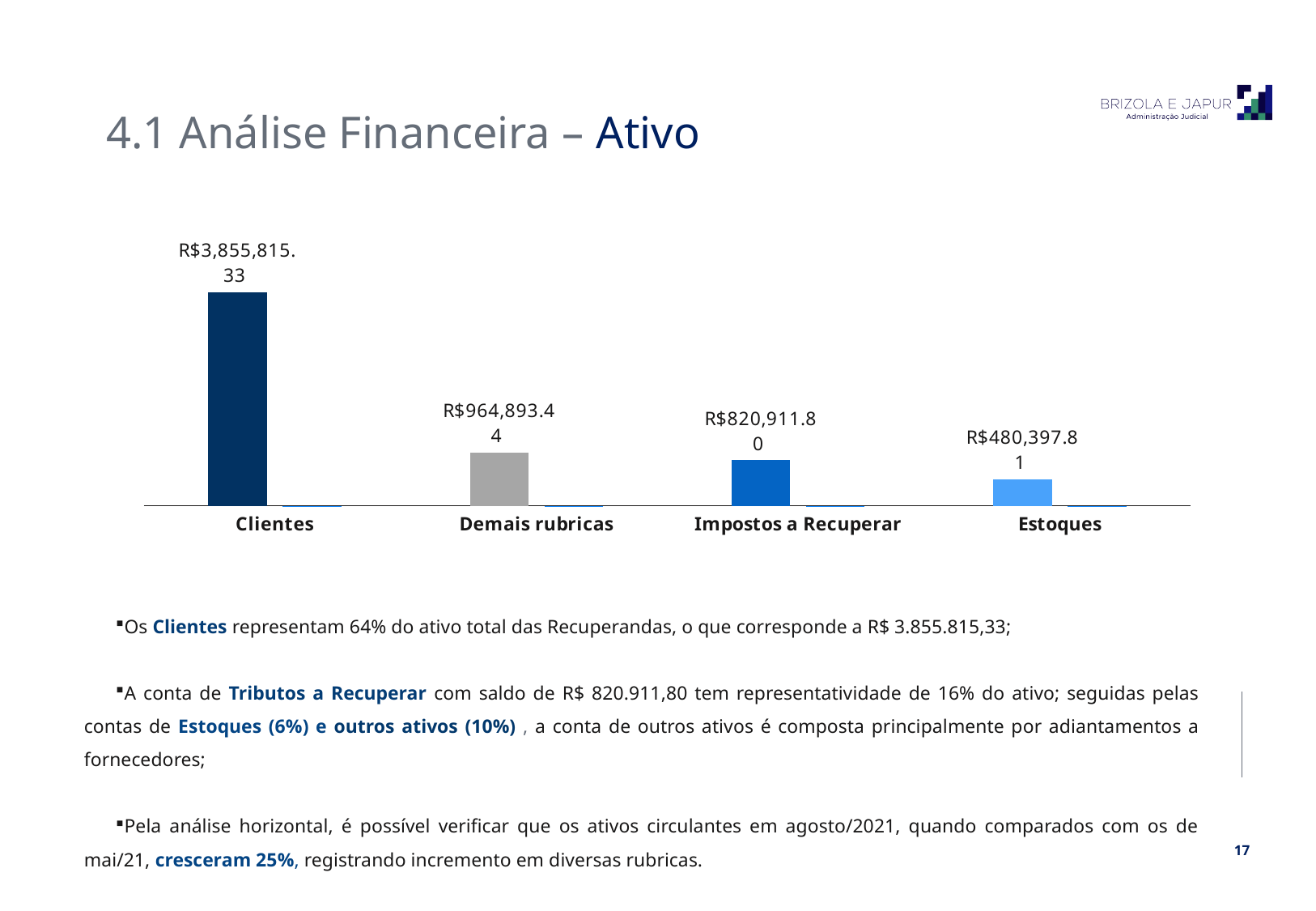
What is the value for Estoques? R$480,397.81 What is the value for Demais rubricas? R$964,893.44 Which category has the lowest value? Estoques What is the value for Clientes? R$3,855,815.33 What is the value for Impostos a Recuperar? R$820,911.80 Which is larger, the value for Demais rubricas or the value for Impostos a Recuperar? Demais rubricas Which category has the highest value? Clientes How many categories are shown in the chart? 4 Do the values rise or fall from left to right across the categories? Fall What is the difference between the values for Clientes and Demais rubricas? R$2,890,921.89 What is the difference between the values for Impostos a Recuperar and Estoques? R$340,513.99 What kind of chart is shown on the slide? Bar chart